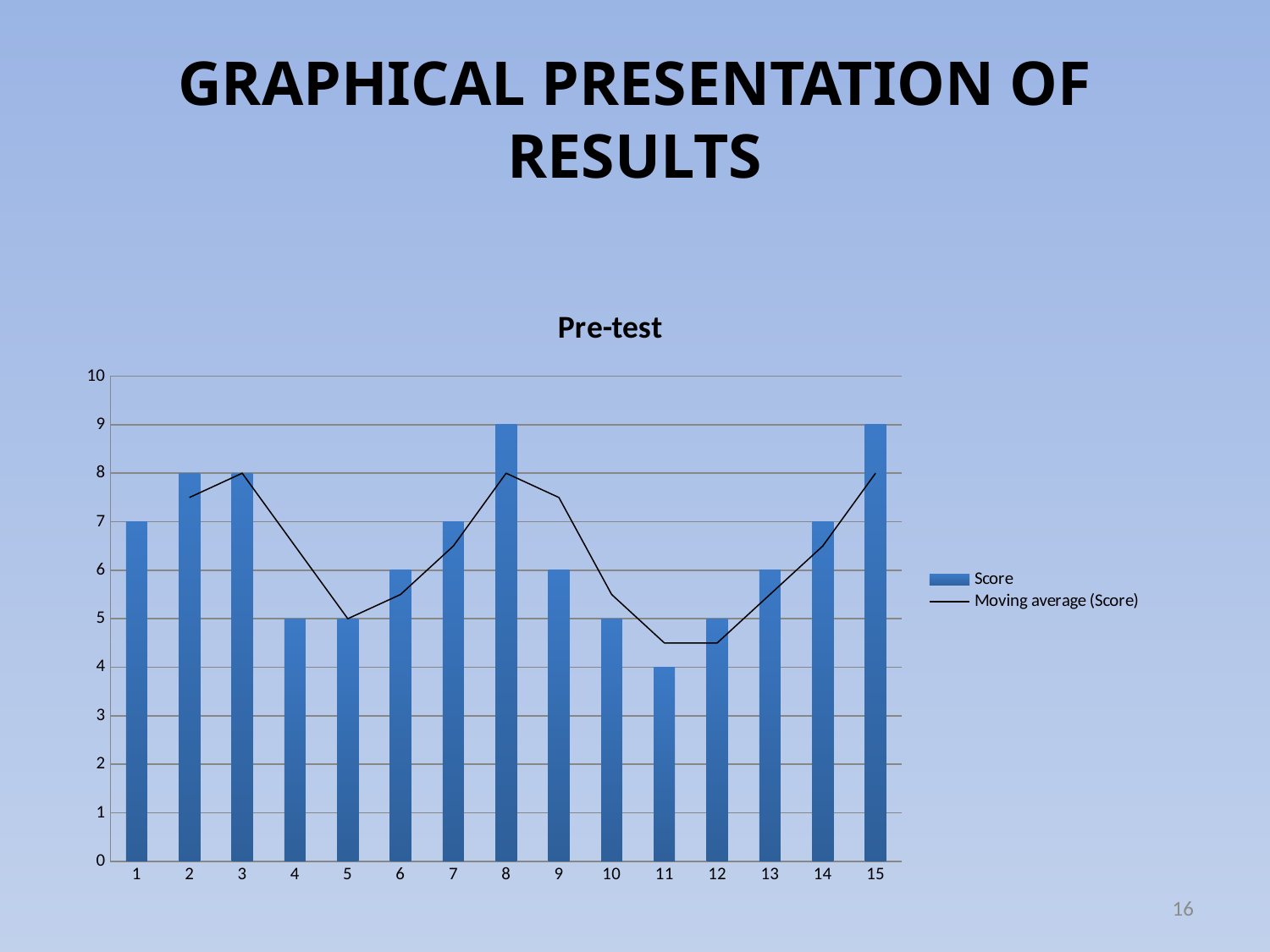
What is the highest Score value shown in the chart? 9 Which category has the lowest Score? 11 What is the title of the chart? Pre-test What is the Score for category 8? 9 What is the Score for category 1? 7 How many categories are shown on the x axis of the chart? 15 What is the name of the line series in the chart's legend? Moving average (Score) How many entries does the chart's legend list? 2 What kind of chart is shown on the slide? bar chart What is the difference between the Score for category 8 and the Score for category 11? 5 Which has a larger Score, category 2 or category 4? category 2 What is the Score for category 11? 4